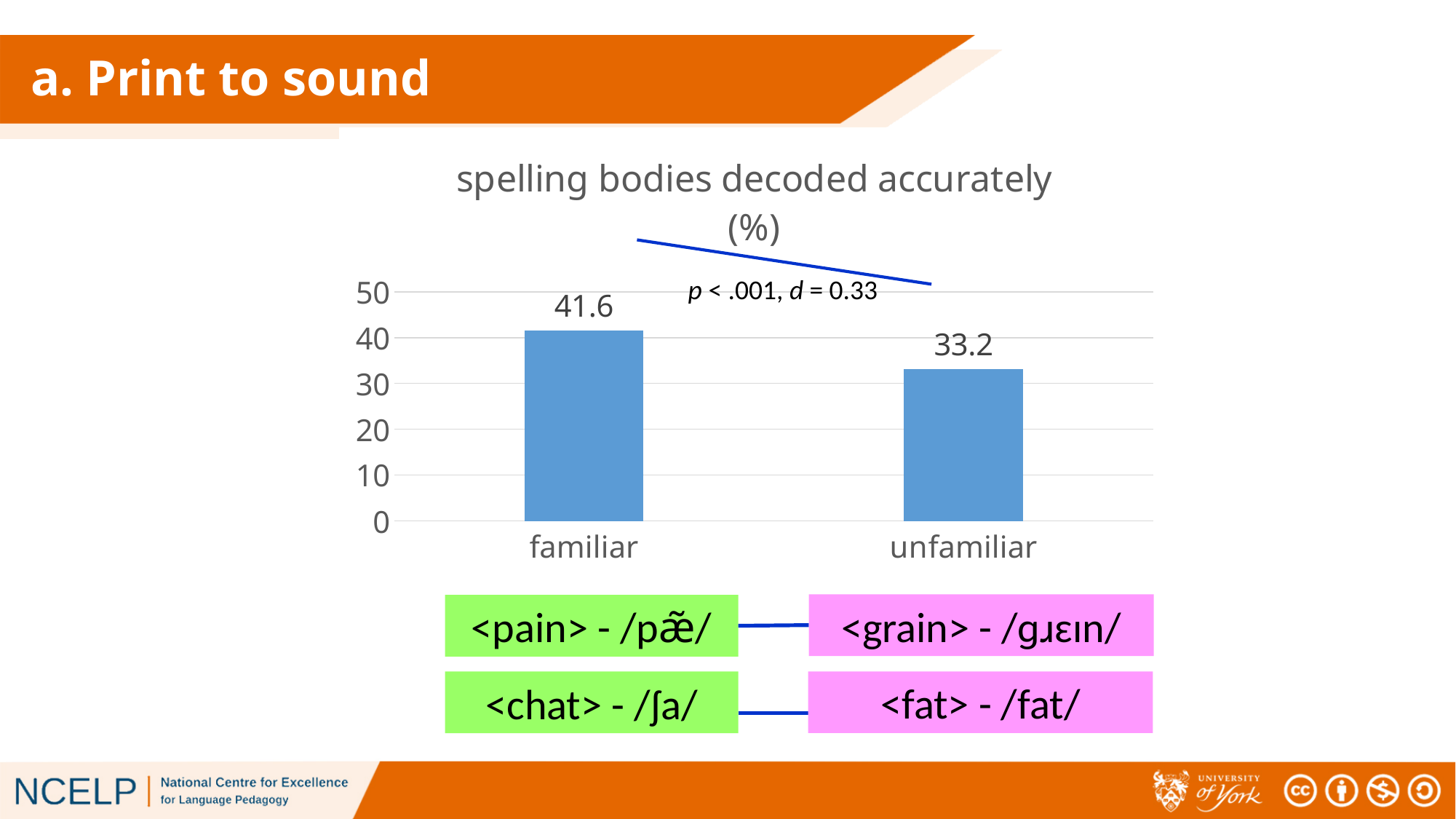
What is the difference between the familiar and unfamiliar values? 8.4 Is the value for unfamiliar greater or less than 40? less Which is larger, the value for familiar or the value for unfamiliar? familiar What is the maximum value shown on the y axis? 50 What is the title of the chart? spelling bodies decoded accurately (%) What is the value for the familiar category? 41.6 What kind of chart is shown? bar chart Which category has the lowest value? unfamiliar Which category has the highest value? familiar What is the value for the unfamiliar category? 33.2 How many categories are shown on the x axis? 2 Is the value for familiar greater or less than 40? greater